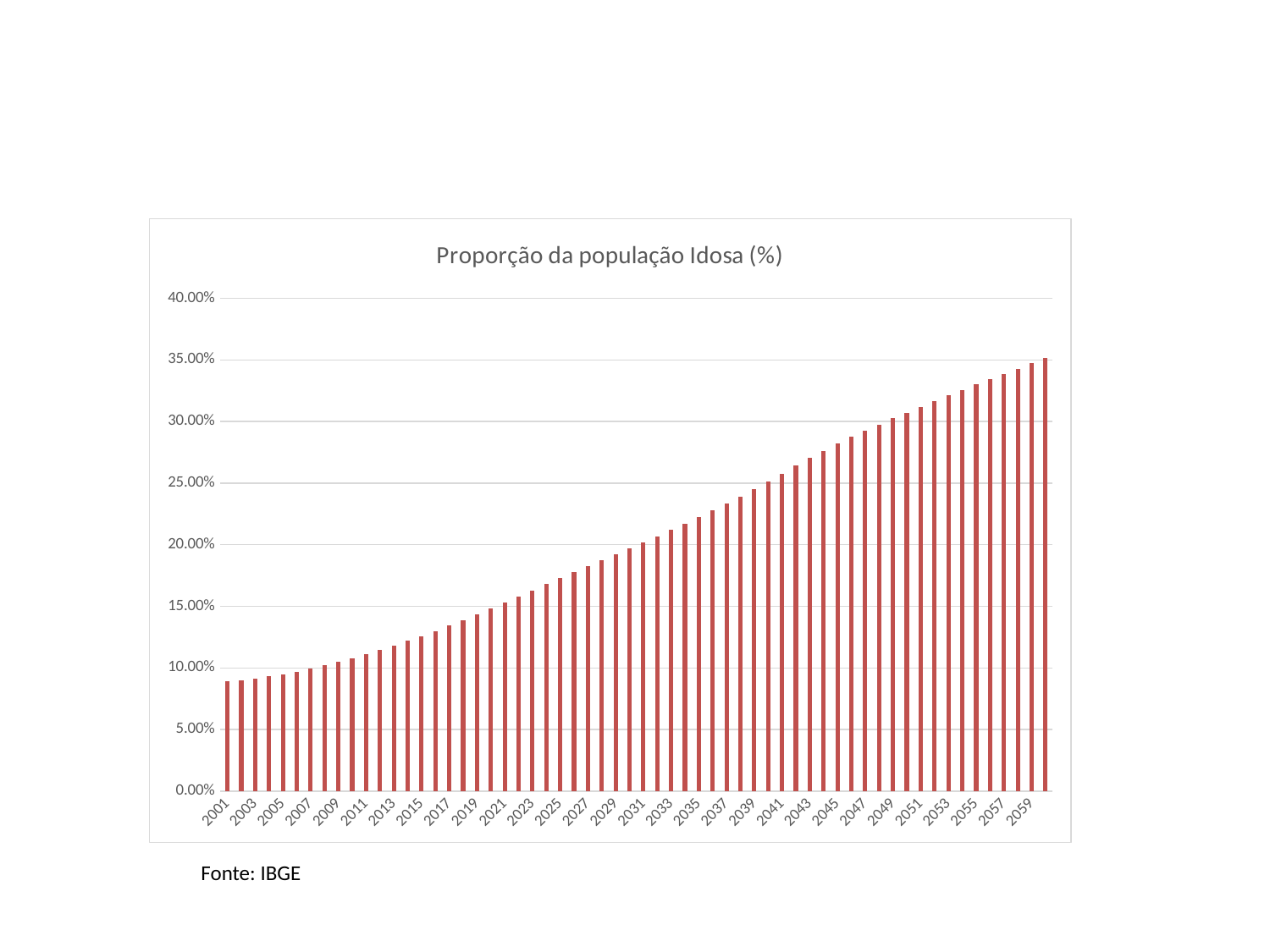
Which is larger, the value for 2021 or the value for 2041? 2041 What source is cited below the chart? IBGE Which is larger, the value for 2059 or the value for 2001? 2059 Is the value for 2001 greater or less than 10.00%? less Do the values rise or fall from 2001 to 2059 along the x axis? rise What is the title of the chart? Proporção da população Idosa (%) Is the value for 2011 greater or less than 10.00%? greater Is the value for 2045 greater or less than 25.00%? greater What kind of chart is shown on the slide? bar chart Which year has the lowest value in the chart? 2001